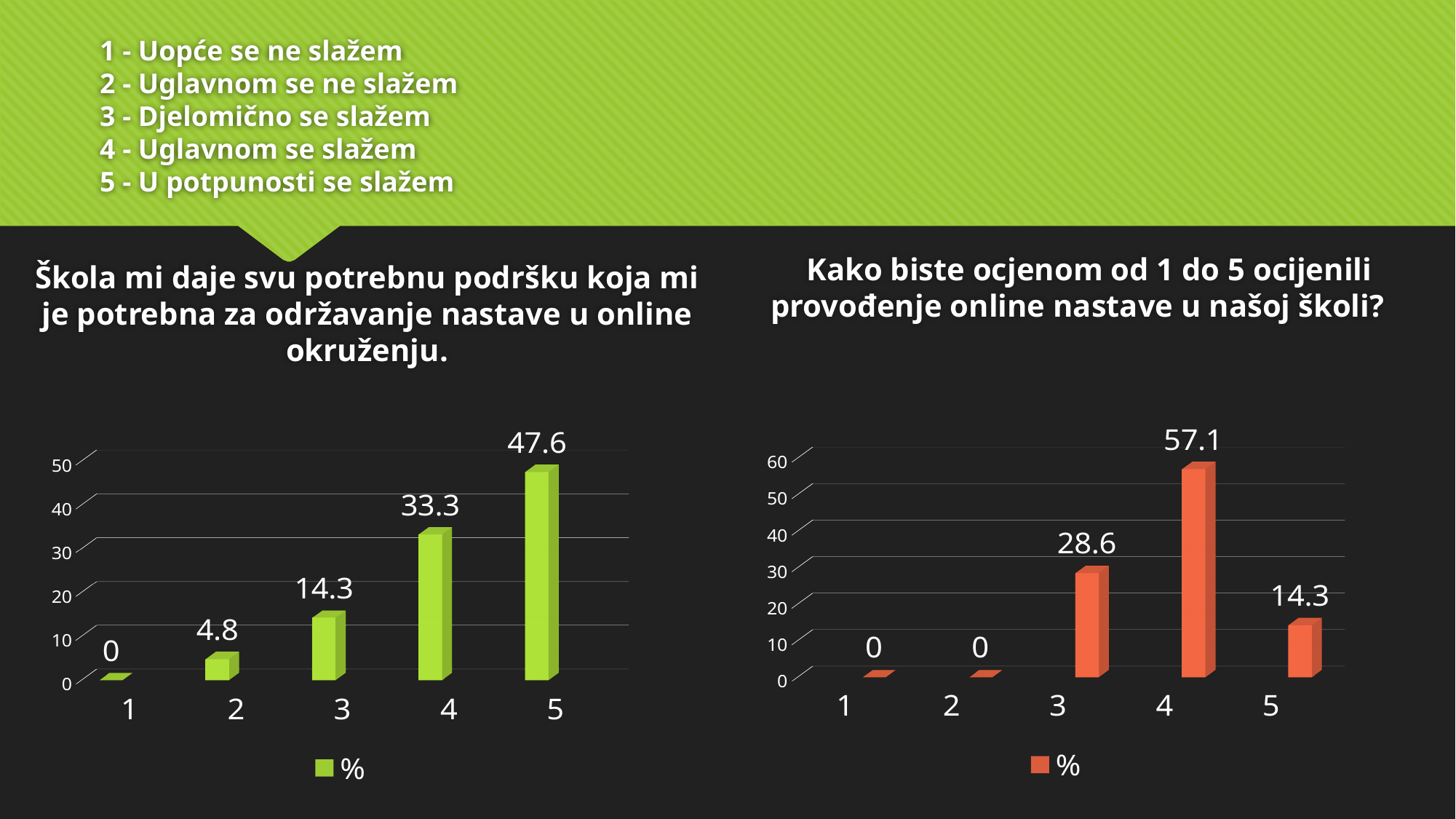
In the left chart ("Škola mi daje svu potrebnu podršku..."), which category has the lowest value? 1 In the right chart ("Kako biste ocjenom od 1 do 5 ocijenili..."), what is the difference between the values for category 4 and category 3? 28.5 In the right chart ("Kako biste ocjenom od 1 do 5 ocijenili..."), what is the value for category 3? 28.6 In the right chart ("Kako biste ocjenom od 1 do 5 ocijenili..."), what is the value for category 4? 57.1 In the left chart ("Škola mi daje svu potrebnu podršku..."), what is the difference between the values for category 5 and category 4? 14.3 In the left chart ("Škola mi daje svu potrebnu podršku..."), what is the value for category 2? 4.8 In the right chart ("Kako biste ocjenom od 1 do 5 ocijenili..."), which category has the highest value? 4 How many categories are shown on the x axis of the left chart ("Škola mi daje svu potrebnu podršku...")? 5 In the right chart ("Kako biste ocjenom od 1 do 5 ocijenili..."), which is larger: the value for category 3 or category 5? 3 In the left chart ("Škola mi daje svu potrebnu podršku..."), what is the value for category 5? 47.6 What kind of chart is the right chart ("Kako biste ocjenom od 1 do 5 ocijenili...")? bar chart In the left chart ("Škola mi daje svu potrebnu podršku..."), which category has the highest value? 5